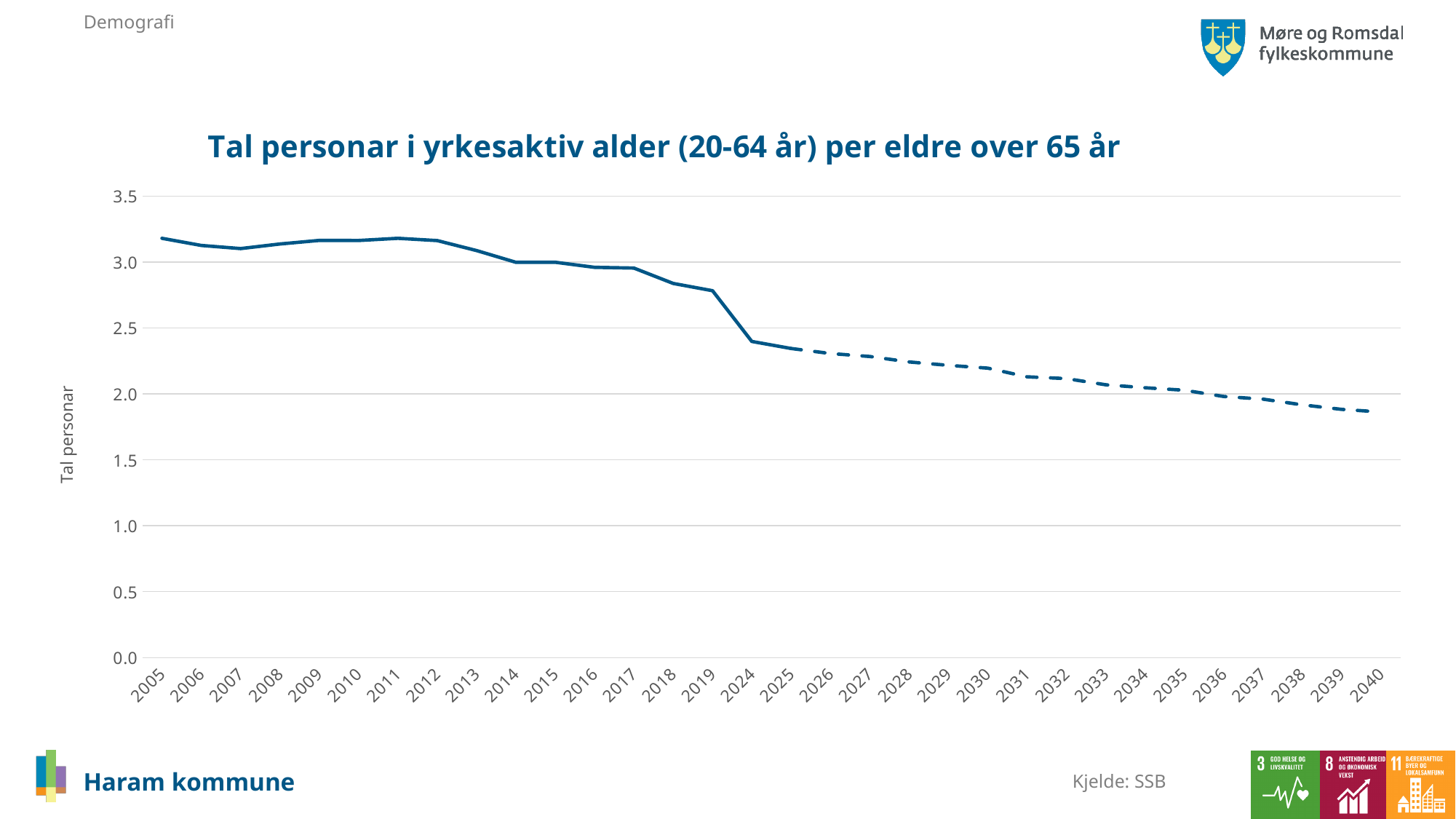
What kind of chart is shown on the slide? line chart How many years are shown on the x axis of the chart? 32 What is the title of the chart? Tal personar i yrkesaktiv alder (20-64 år) per eldre over 65 år Which year has the larger value, 2019 or 2024? 2019 Is the value for 2040 greater or less than 2.0? less Is the value for 2019 greater or less than 2.5? greater Do the values generally rise or fall from 2005 to 2040? fall Which year has the lowest value on the chart? 2040 What is the label on the y axis of the chart? Tal personar Is the value for 2024 greater or less than 2.5? less Which year has the larger value, 2005 or 2040? 2005